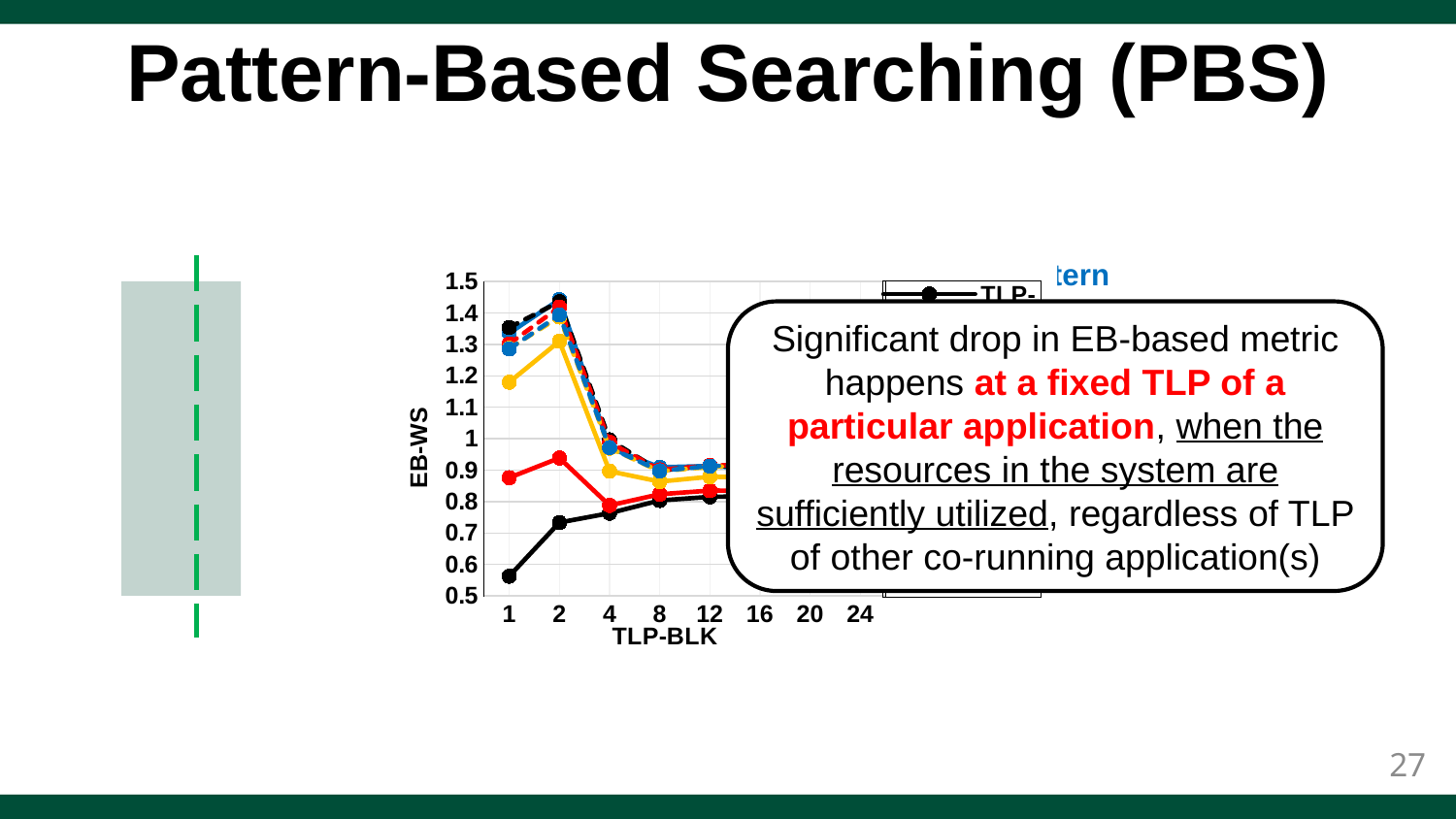
Is the value of the solid red line at TLP-BLK = 2 greater or less than 0.9? greater Is the value of the solid yellow line at TLP-BLK = 1 greater or less than 1.1? greater Do the dashed lines rise or fall as TLP-BLK increases from 2 to 8? fall Is the value of the solid black line at TLP-BLK = 2 greater or less than 0.8? less At TLP-BLK = 1, which is larger: the solid red line or the solid black line? the solid red line Does the solid black line rise or fall as TLP-BLK increases from 1 to 12? rise What is the label of the x axis of the chart? TLP-BLK What is the label of the y axis of the chart? EB-WS Which line has the lowest value at TLP-BLK = 1? the solid black line What kind of chart is shown on the slide? line chart